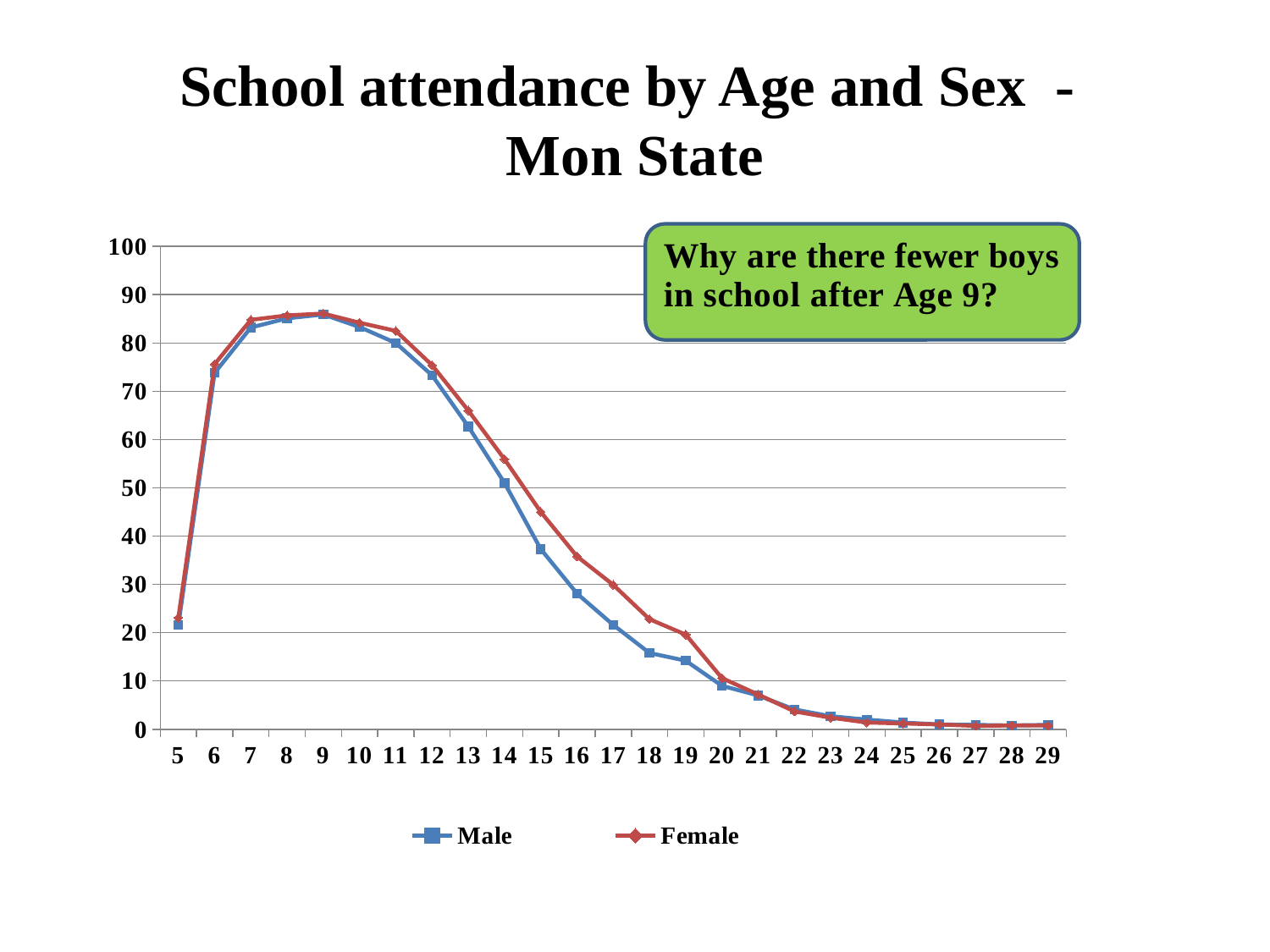
At age 17, which series has the higher value, Male or Female? Female Which colour is used for the Female series? red Do the values for both series rise or fall from age 9 to age 29? fall Is the Female value at age 15 greater or less than 40? greater How many series does the legend list? 2 What is the title of the chart? School attendance by Age and Sex - Mon State How many age categories are plotted along the x axis? 25 Is the Male value at age 18 greater or less than 20? less Is the Female value at age 16 greater or less than 40? less What kind of chart is shown on the slide? line chart